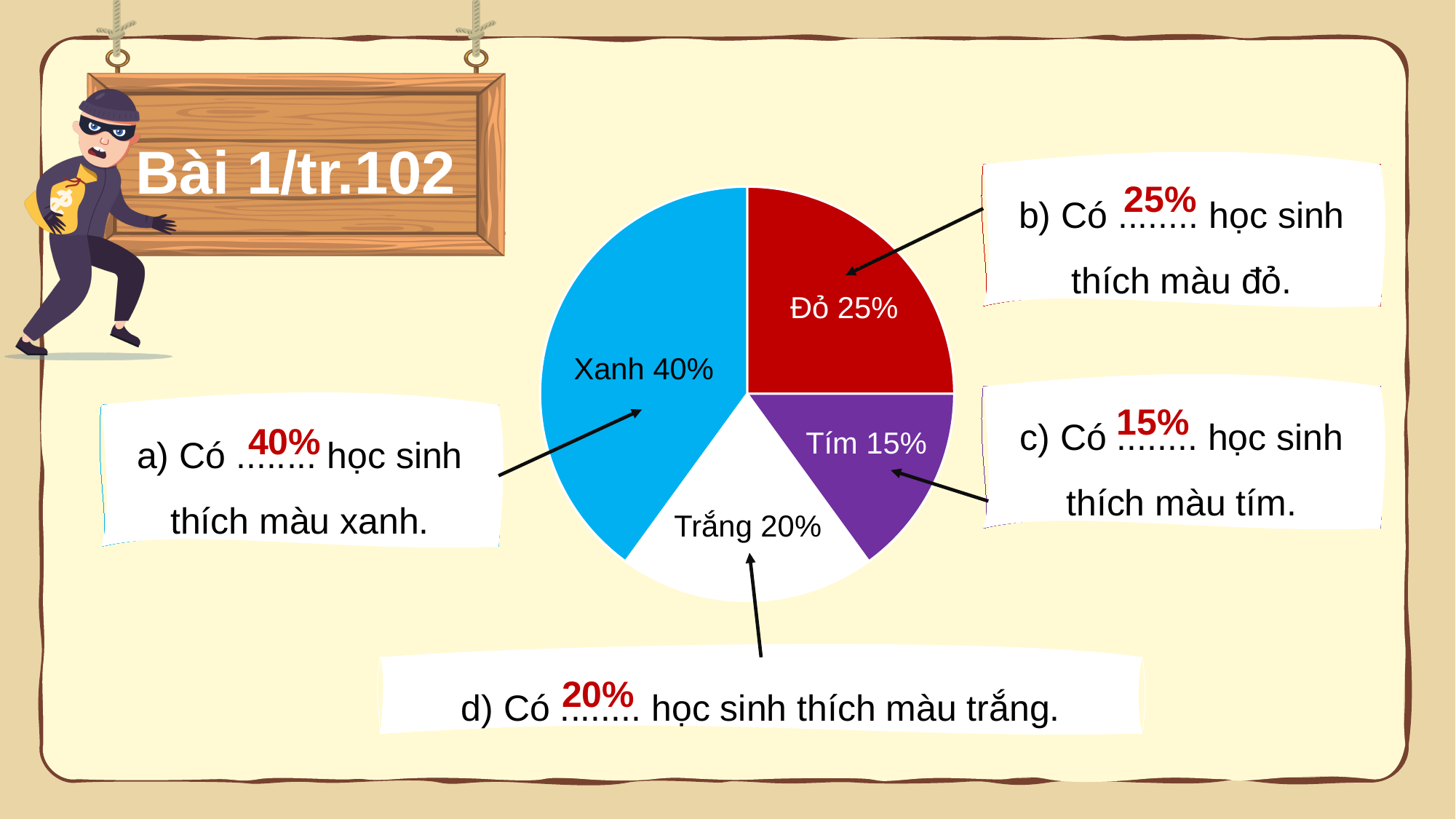
What share of the pie does Tím (purple) have? 15% What share of the pie does Trắng (white) have? 20% Which colour has the largest slice of the pie? Xanh What share of the pie does Đỏ (red) have? 25% What is the combined share of Đỏ and Tím? 40% Which colour has the smallest slice of the pie? Tím What is the difference between the shares for Xanh and Tím? 25% How many slices does the pie chart have? 4 Which is larger, the share for Đỏ or the share for Trắng? Đỏ What is the difference between the shares for Đỏ and Trắng? 5% What kind of chart is shown on the slide? pie chart